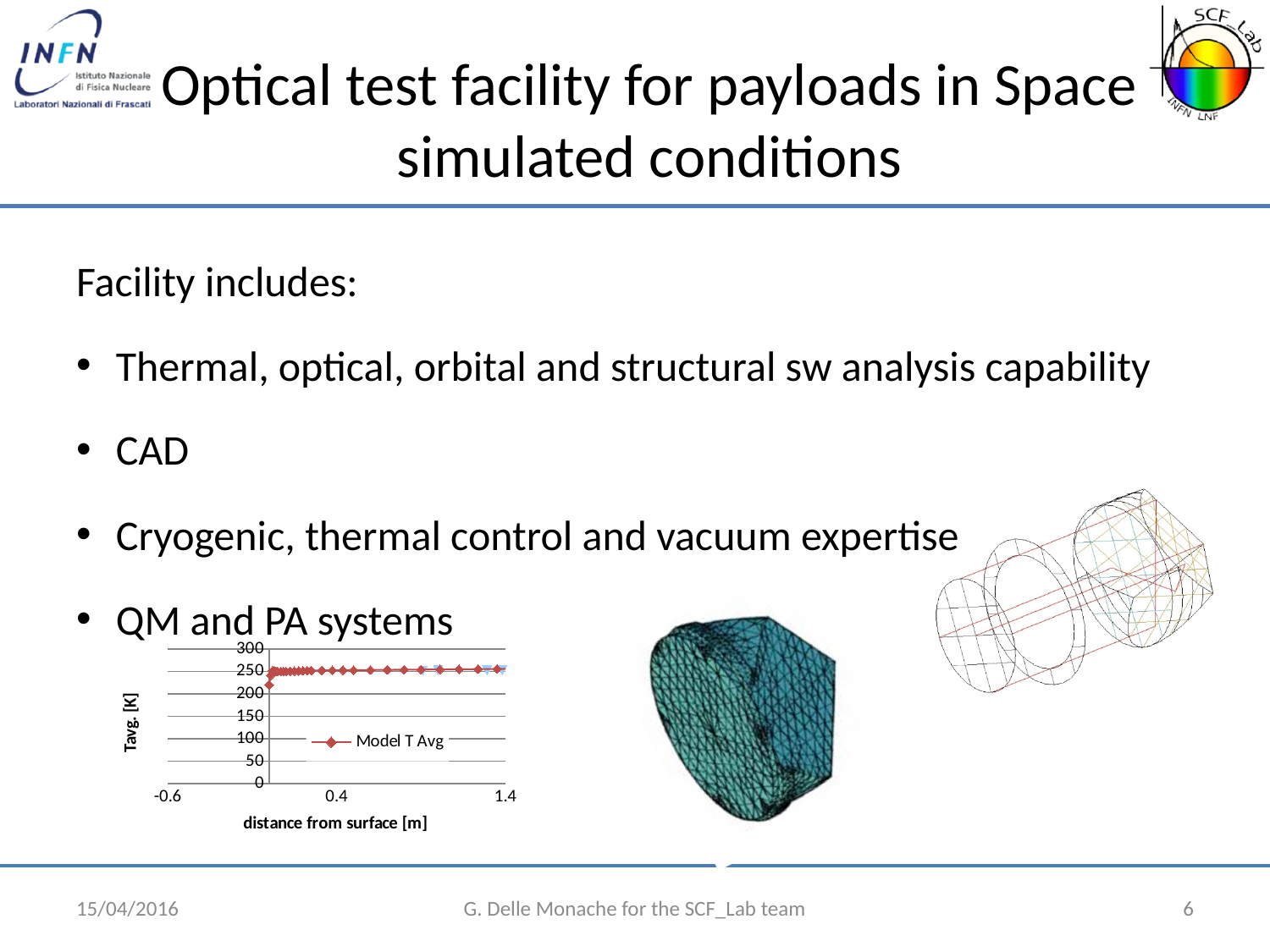
Is the value of Model T Avg at the first plotted point greater or less than 250? less How many series does the legend of the chart list? 1 Is the value of Model T Avg at a distance of 0.4 m greater or less than 150? greater Is the value of Model T Avg at the first plotted point greater or less than 200? greater What is the title of the vertical axis of the chart? Tavg. [K] What kind of chart is shown at the bottom left of the slide? line chart What is the name of the series shown in the chart legend? Model T Avg What is the highest tick value shown on the vertical axis of the chart? 300 Do the Model T Avg values rise or fall between the first and second plotted points? rise